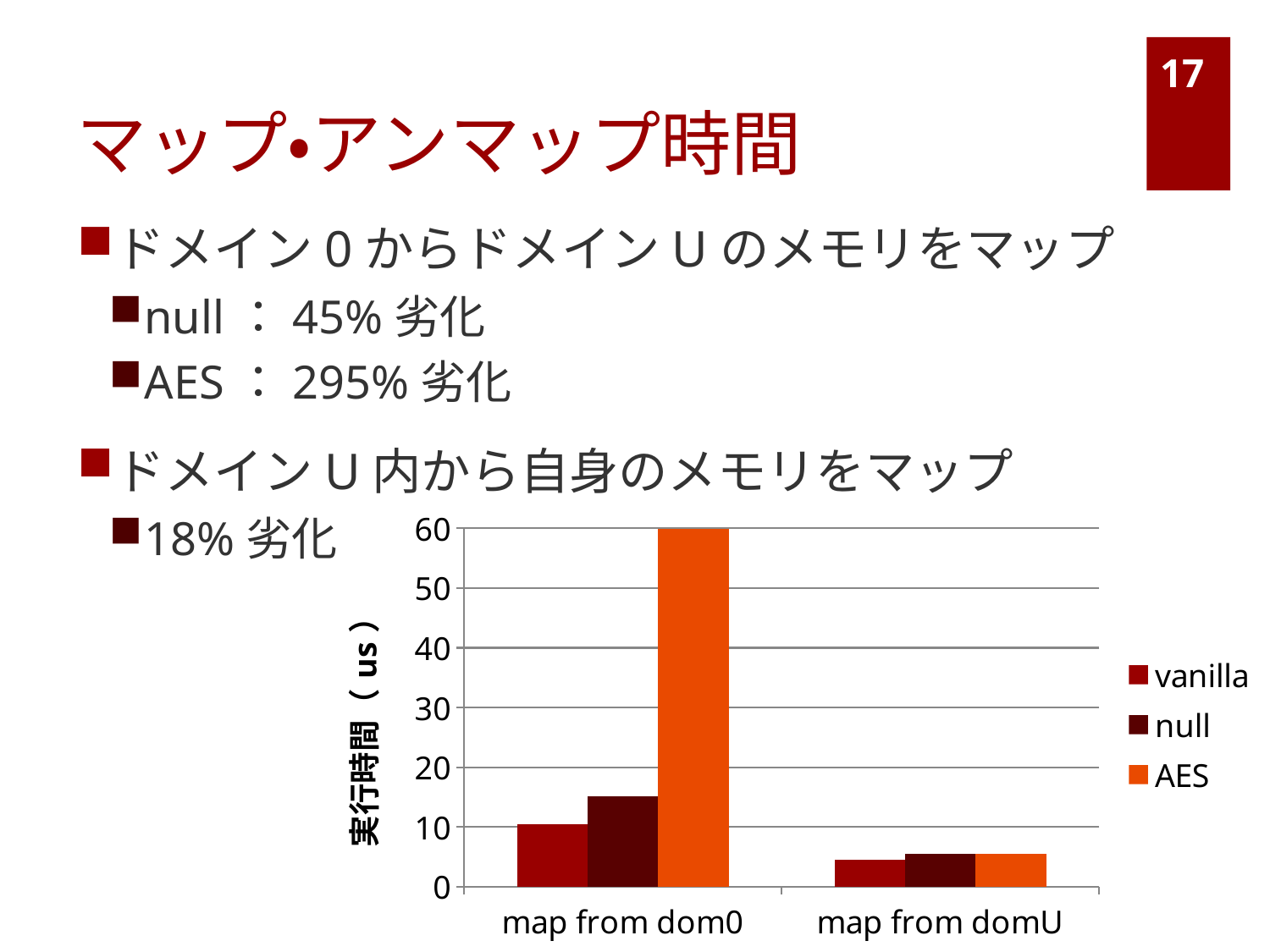
For the category 'map from dom0', which series has the highest value? AES What are the legend entries of the chart, in order? vanilla, null, AES Which series has the tallest bar in the chart? AES For the category 'map from dom0', which series has the lowest value? vanilla What kind of chart is shown on the slide? bar chart Is the AES value for 'map from domU' greater or less than 10? less Is the null value for 'map from dom0' greater or less than 10? greater How many categories are shown on the x axis of the chart? 2 Is the AES value for 'map from dom0' greater or less than 50? greater For 'map from dom0', which is larger: the null value or the vanilla value? null How many series does the chart's legend list? 3